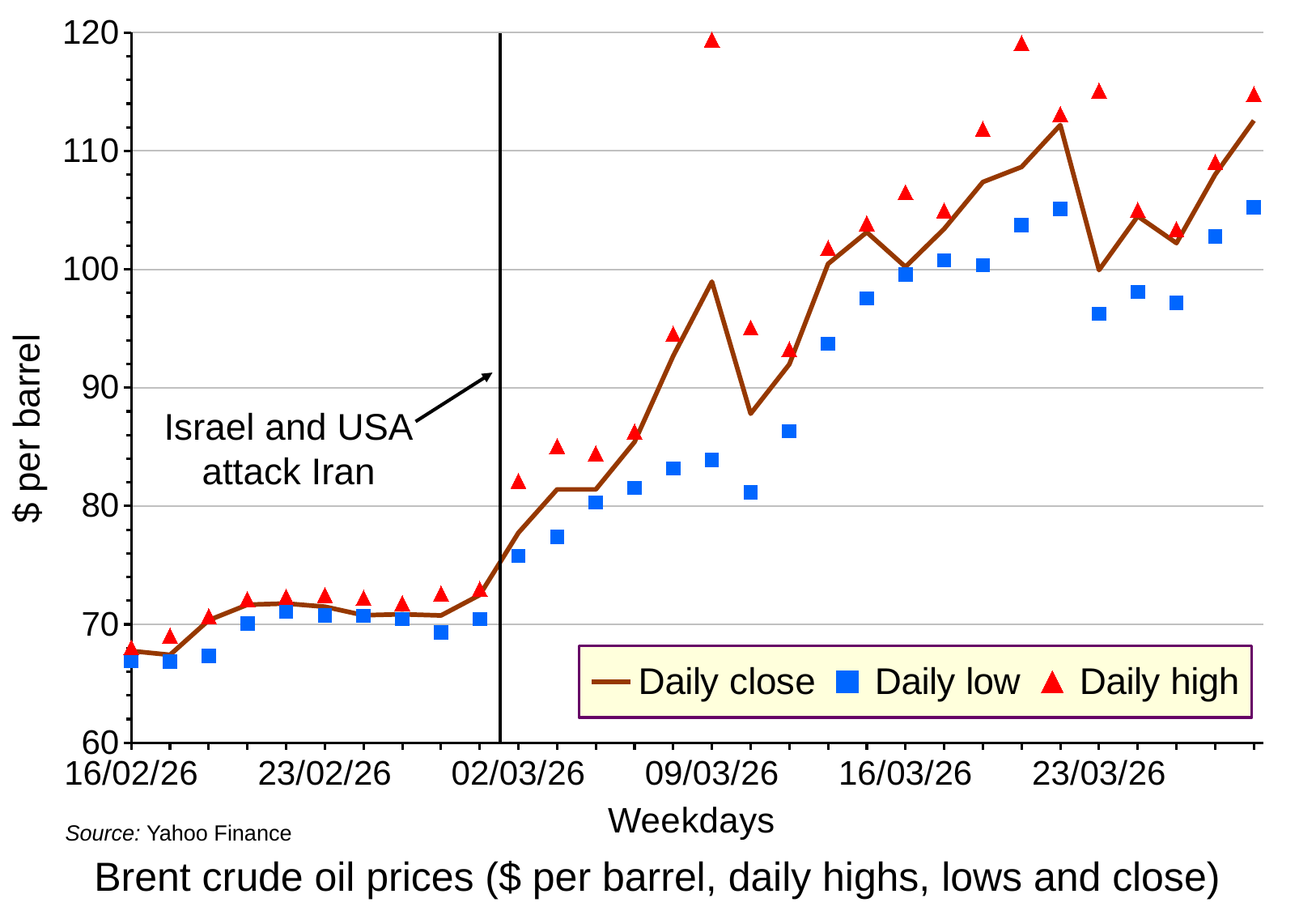
Is the Daily close value on 16/02/26 greater or less than 70? less Is the Daily high value on 23/03/26 greater or less than 110? greater What kind of chart is shown on the slide? line chart How many date labels are shown on the x axis? 6 Does the Daily close series generally rise or fall from 16/02/26 to the end of the chart? rise Is the Daily high value on 09/03/26 greater or less than 110? greater Which series is drawn as a solid brown line? Daily close How many series does the legend list? 3 What event does the annotation with the arrow mark on the chart? Israel and USA attack Iran